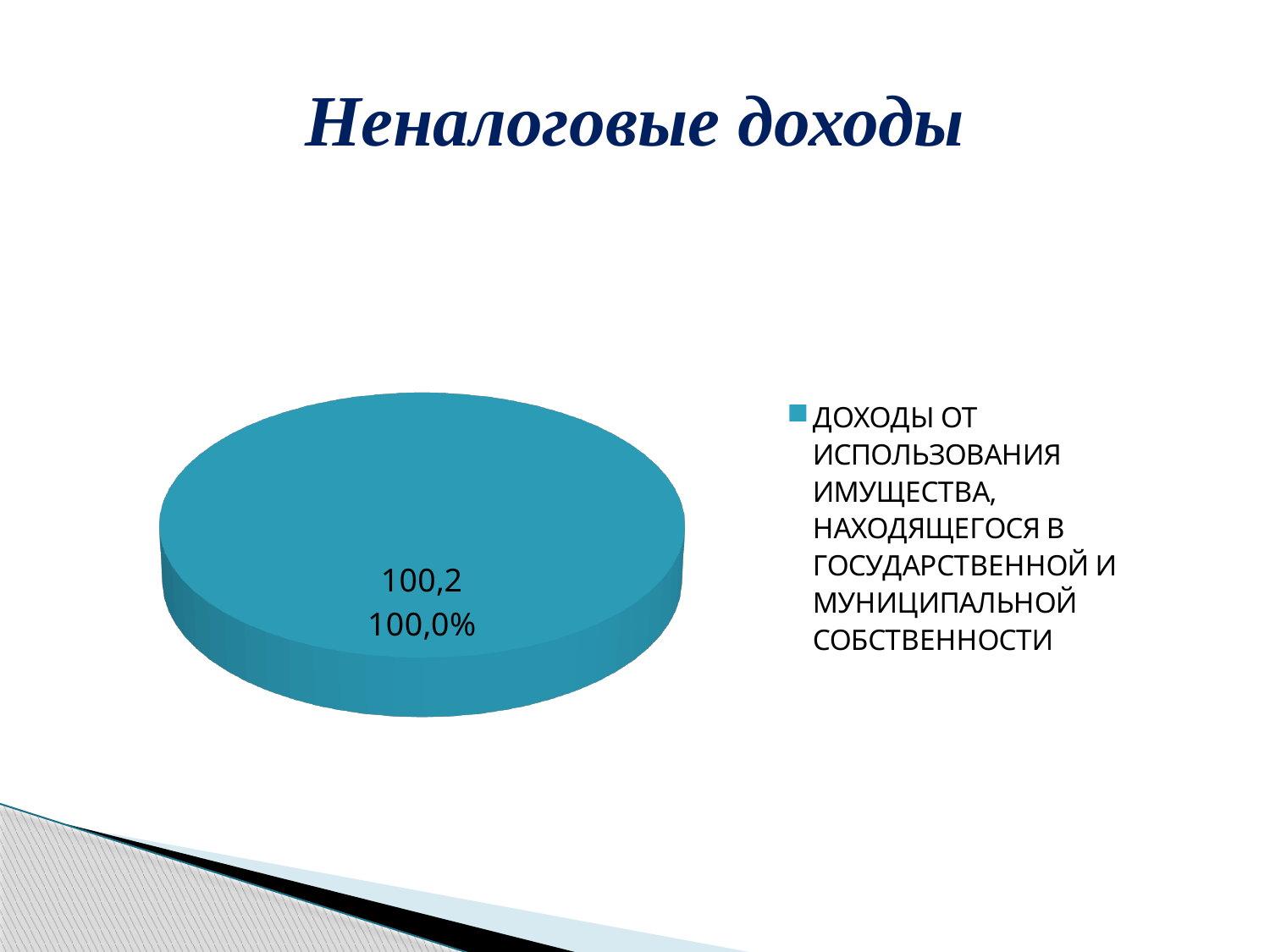
Which category is the largest in the pie chart? ДОХОДЫ ОТ ИСПОЛЬЗОВАНИЯ ИМУЩЕСТВА, НАХОДЯЩЕГОСЯ В ГОСУДАРСТВЕННОЙ И МУНИЦИПАЛЬНОЙ СОБСТВЕННОСТИ What colour is the single slice of the pie chart? teal blue What value is printed on the slice for ДОХОДЫ ОТ ИСПОЛЬЗОВАНИЯ ИМУЩЕСТВА, НАХОДЯЩЕГОСЯ В ГОСУДАРСТВЕННОЙ И МУНИЦИПАЛЬНОЙ СОБСТВЕННОСТИ? 100,2 How many slices does the pie chart have? 1 What kind of chart is shown on the slide? pie chart What is the title of the slide containing the pie chart? Неналоговые доходы How many entries does the legend list? 1 What share of the pie does the slice for ДОХОДЫ ОТ ИСПОЛЬЗОВАНИЯ ИМУЩЕСТВА, НАХОДЯЩЕГОСЯ В ГОСУДАРСТВЕННОЙ И МУНИЦИПАЛЬНОЙ СОБСТВЕННОСТИ represent? 100,0%